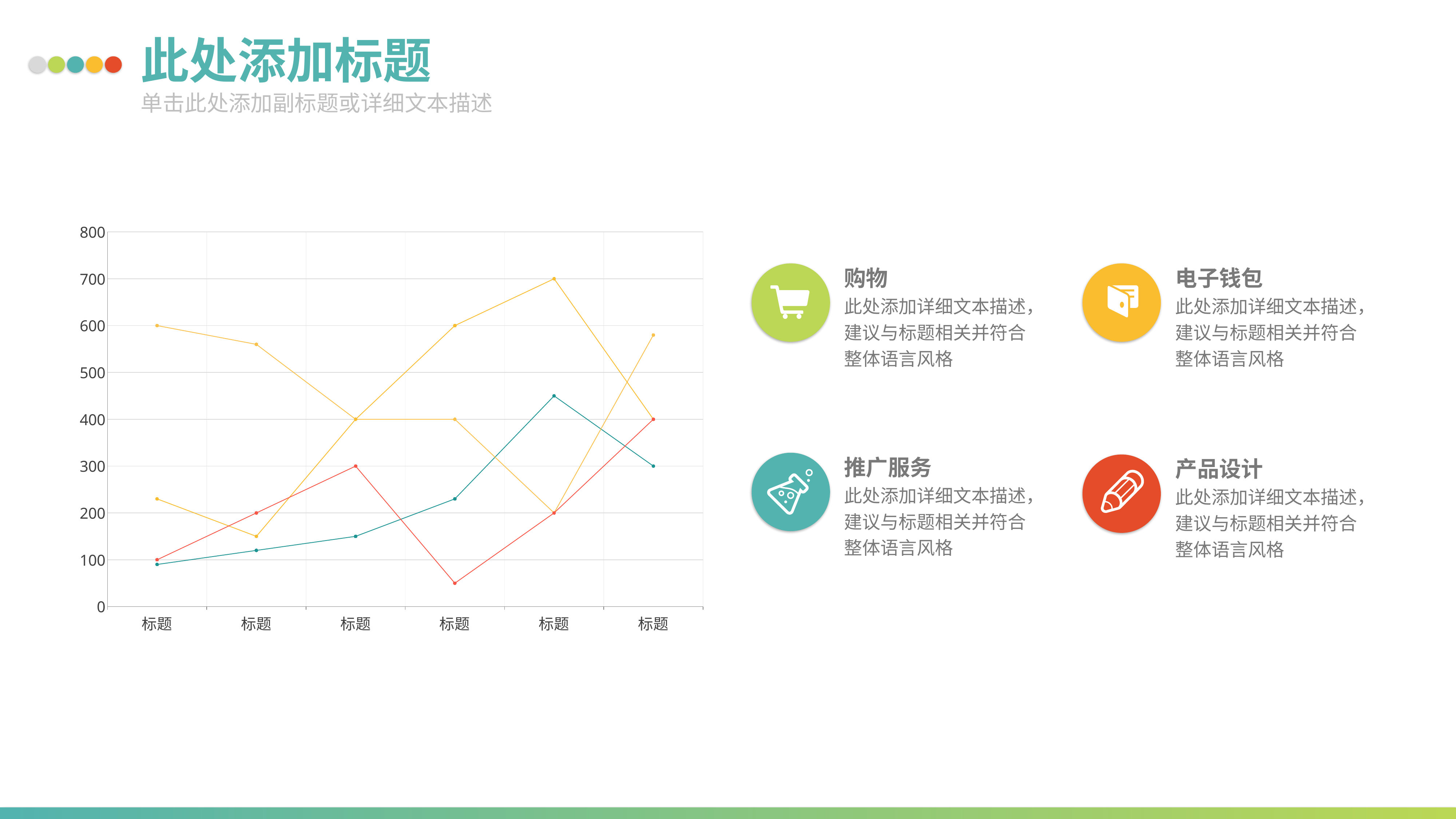
How many lines are plotted on the chart? 4 At which category does the teal line reach its highest value? the fifth category How many categories are shown along the x axis of the chart? 6 Is the value of the red line at the fourth category greater or less than 100? less Does the teal line rise or fall from the first category to the fifth category? rise Is the value of the teal line at the third category greater or less than 200? less At the last category, which line has the larger value, the red line or the teal line? the red line What is the highest value shown on the chart's y axis? 800 At which category does the red line reach its lowest value? the fourth category Is the value of the teal line at the fifth category greater or less than 400? greater What kind of chart is shown on the slide? line chart